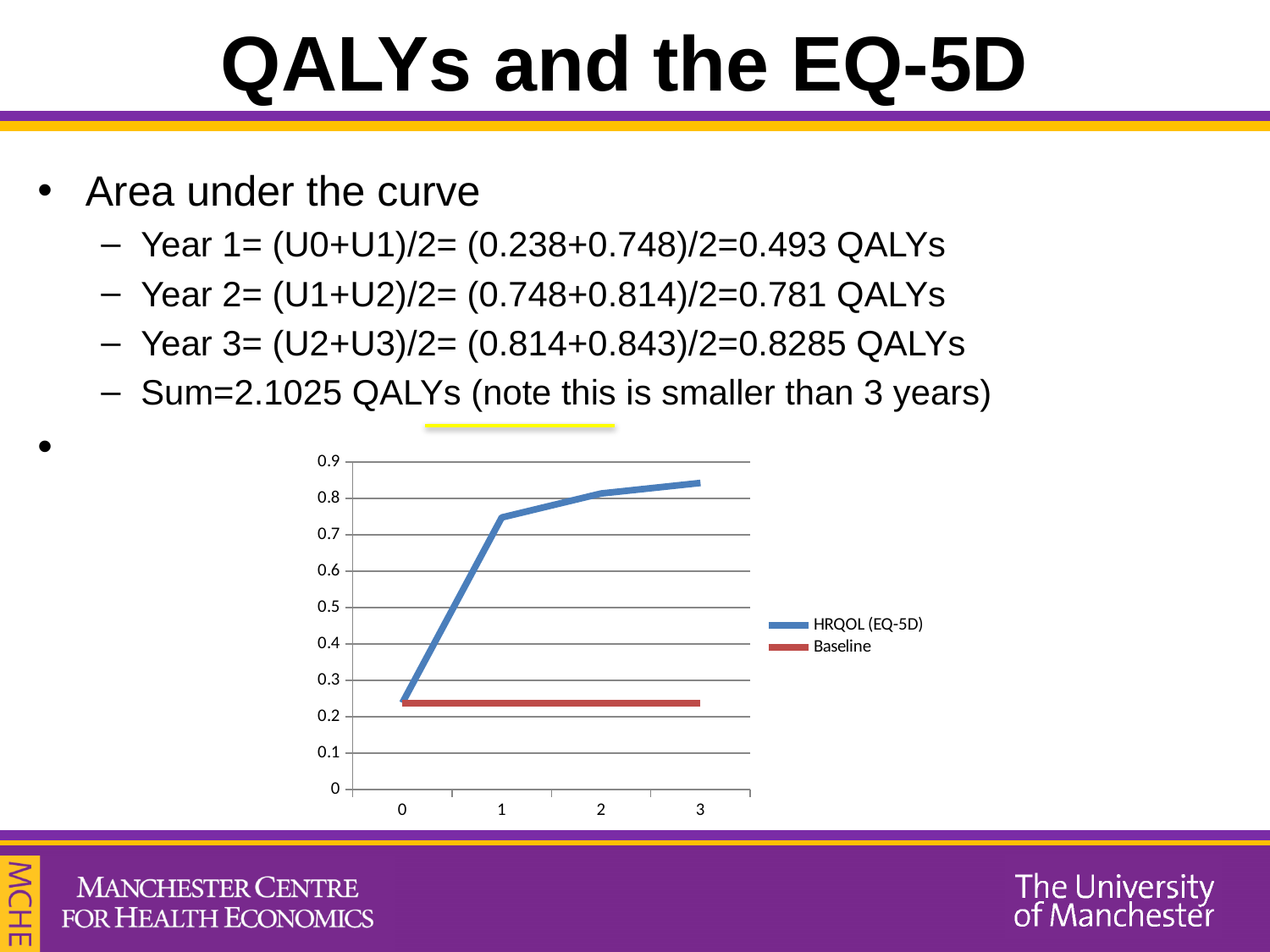
Does the HRQOL (EQ-5D) line rise or fall as x goes from 0 to 3? rises Is the Baseline value at x = 2 greater or less than 0.3? less How many series does the chart's legend list? 2 At which x value is the HRQOL (EQ-5D) series highest? 3 Is the HRQOL (EQ-5D) value at x = 1 greater or less than 0.7? greater At which x value is the HRQOL (EQ-5D) series lowest? 0 Is the HRQOL (EQ-5D) value at x = 3 greater or less than 0.8? greater What kind of chart is shown on the slide? line chart How many x-axis points (0 to 3) are plotted for the HRQOL (EQ-5D) series? 4 What are the two series named in the chart's legend? HRQOL (EQ-5D) and Baseline What colour is the Baseline line in the chart? red At x = 2, which series has the larger value, HRQOL (EQ-5D) or Baseline? HRQOL (EQ-5D)